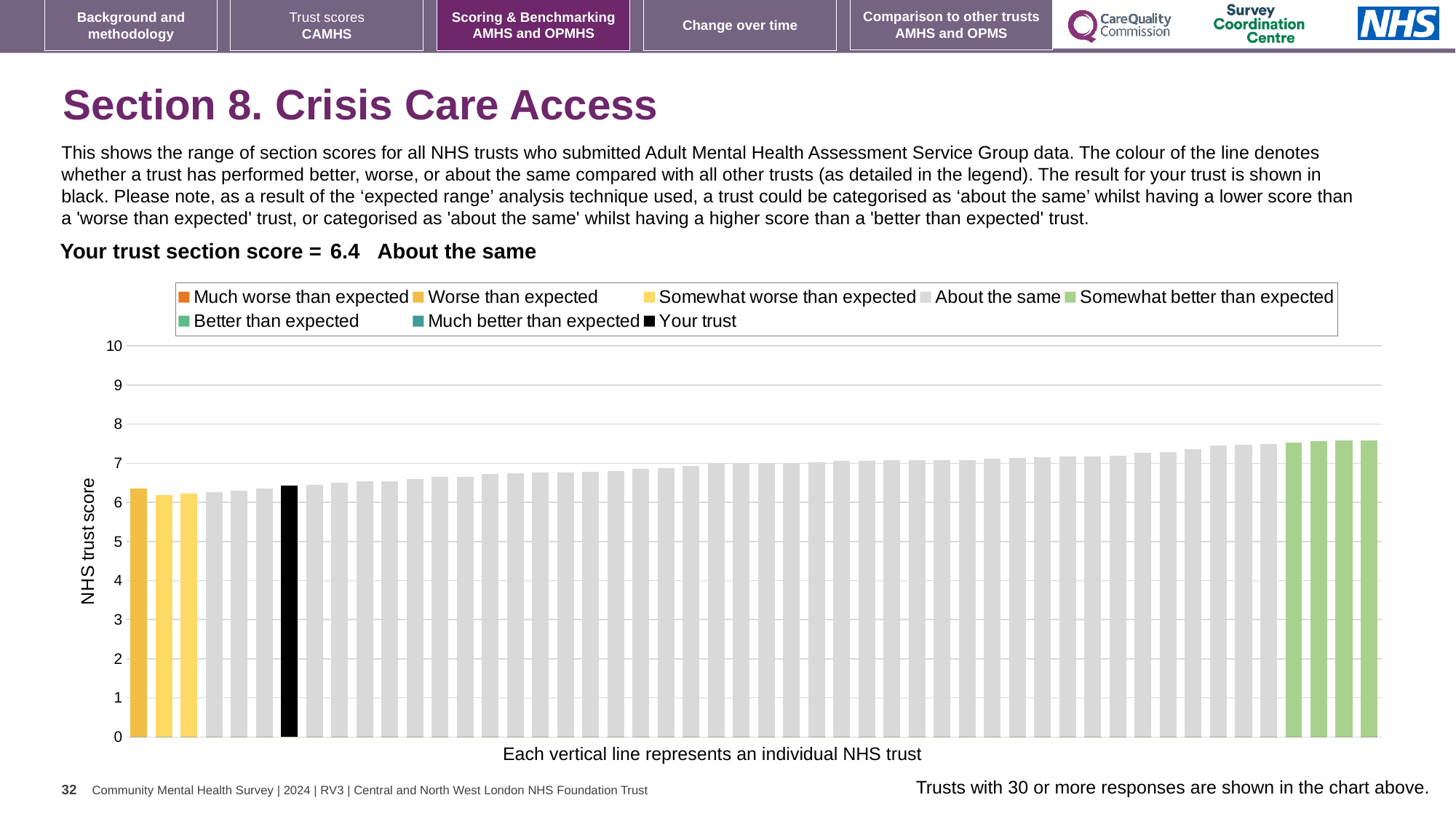
Do the bar values rise or fall from left to right along the x axis? rise Is the tallest bar in the chart greater or less than 8? less Is the shortest bar in the chart greater or less than 6? greater How many bars are coloured as 'Somewhat better than expected'? 4 What is the label on the vertical axis of the chart? NHS trust score How many entries does the chart legend list? 8 Which is larger: the bar for your trust or the rightmost green bar? the rightmost green bar What is the section score for your trust? 6.4 Which category is your trust placed in for this section? About the same Is the value for your trust greater or less than 5? greater How many bars are coloured as 'Somewhat worse than expected'? 2 What kind of chart is shown on the slide? bar chart